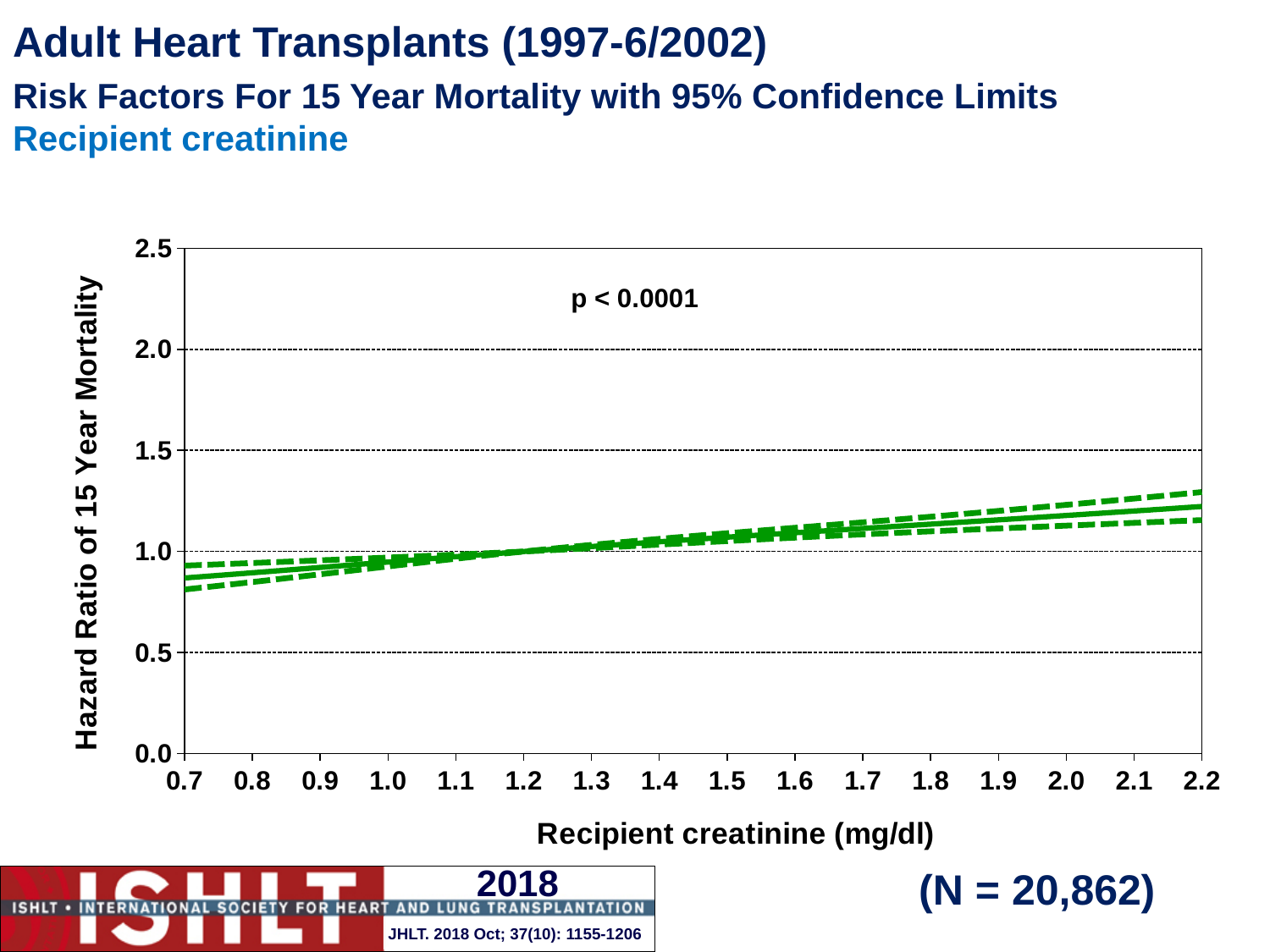
What is the label of the x axis? Recipient creatinine (mg/dl) Is the hazard ratio at a recipient creatinine of 0.7 mg/dl greater or less than 0.5? greater Is the hazard ratio at a recipient creatinine of 2.2 mg/dl greater or less than 1.5? less What p-value is printed on the chart? p < 0.0001 Is the hazard ratio at a recipient creatinine of 2.2 mg/dl greater or less than 1.0? greater What is the highest value labelled on the y axis? 2.5 How many lines are plotted on the chart (including the confidence limits)? 3 What kind of chart is shown on the slide? line chart How many tick labels are shown on the x axis? 16 Does the hazard ratio of 15 year mortality rise or fall as recipient creatinine increases from 0.7 to 2.2 mg/dl? rise What sample size (N) is printed on the slide? N = 20,862